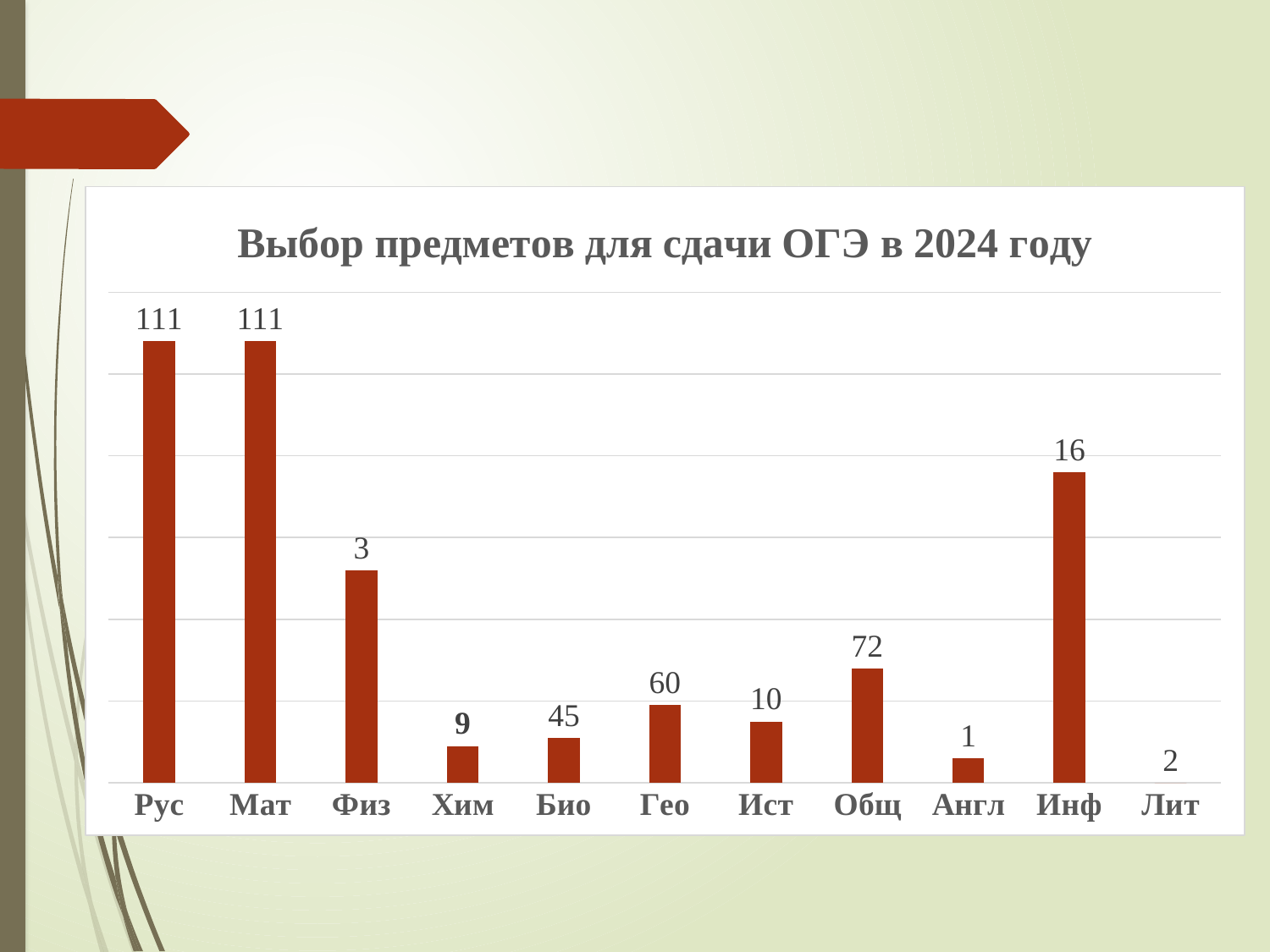
What is the value for Инф? 16 How many subjects (categories) are shown on the x axis? 11 What is the value for Англ? 1 What is the value for Гео? 60 What is the value for Био? 45 What is the difference between the values for Общ and Гео? 12 What is the value for Лит? 2 Which is larger, the value for Общ or the value for Гео? Общ What is the value for Общ? 72 What is the title of the chart? Выбор предметов для сдачи ОГЭ в 2024 году What is the value for Рус? 111 What kind of chart is shown on the slide? Bar chart